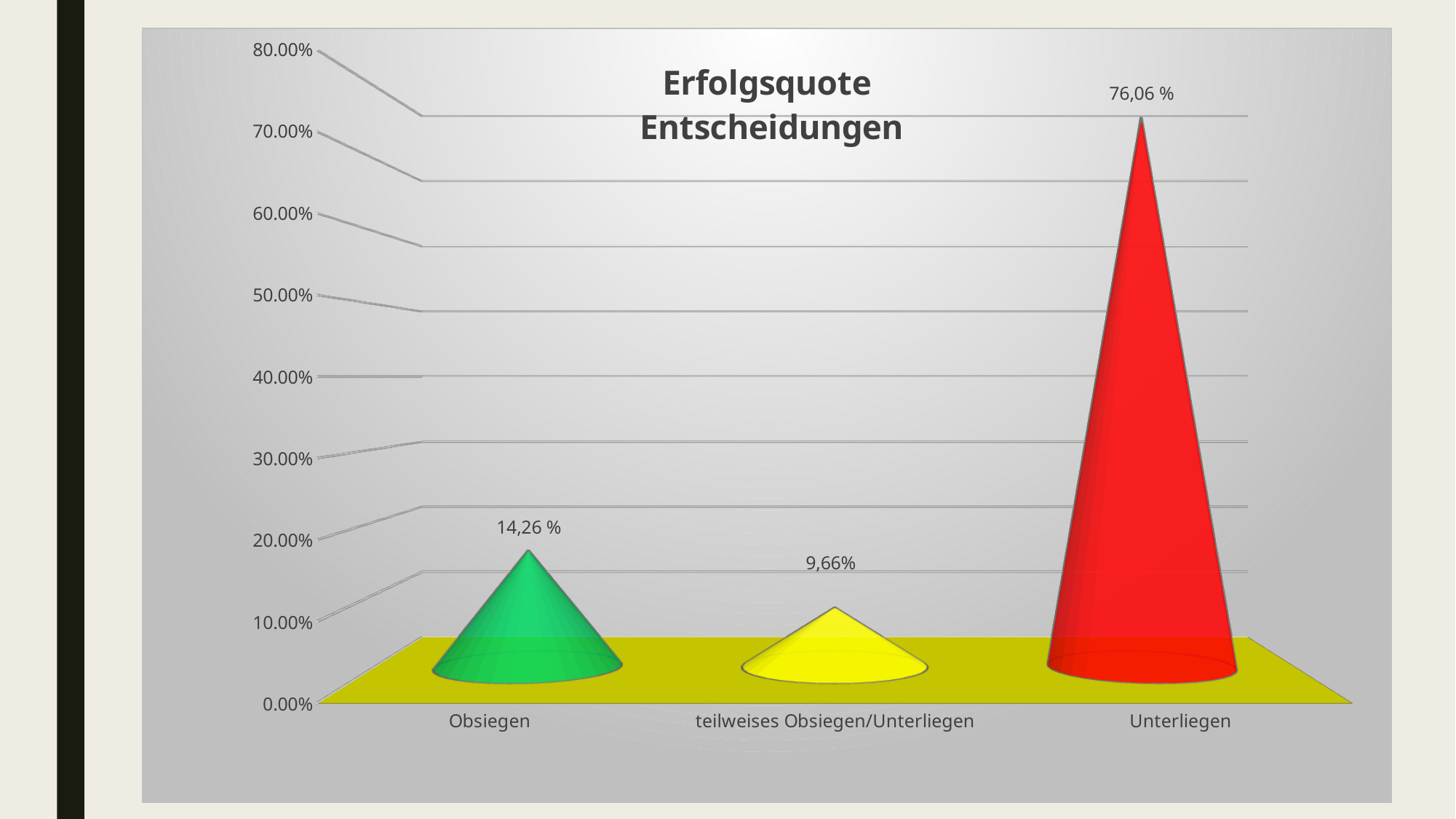
Which is larger, the value for Obsiegen or the value for teilweises Obsiegen/Unterliegen? Obsiegen What is the title of the chart? Erfolgsquote Entscheidungen What is the value for Unterliegen? 76,06 % Which category has the lowest value? teilweises Obsiegen/Unterliegen What is the value for teilweises Obsiegen/Unterliegen? 9,66% What is the difference between the values for Obsiegen and teilweises Obsiegen/Unterliegen? 4,60 % What kind of chart is shown on the slide? bar chart How many categories are shown on the x axis? 3 What is the difference between the values for Unterliegen and Obsiegen? 61,80 % Which category has the highest value? Unterliegen What is the value for Obsiegen? 14,26 % Is the value for Unterliegen greater or less than 70.00%? greater